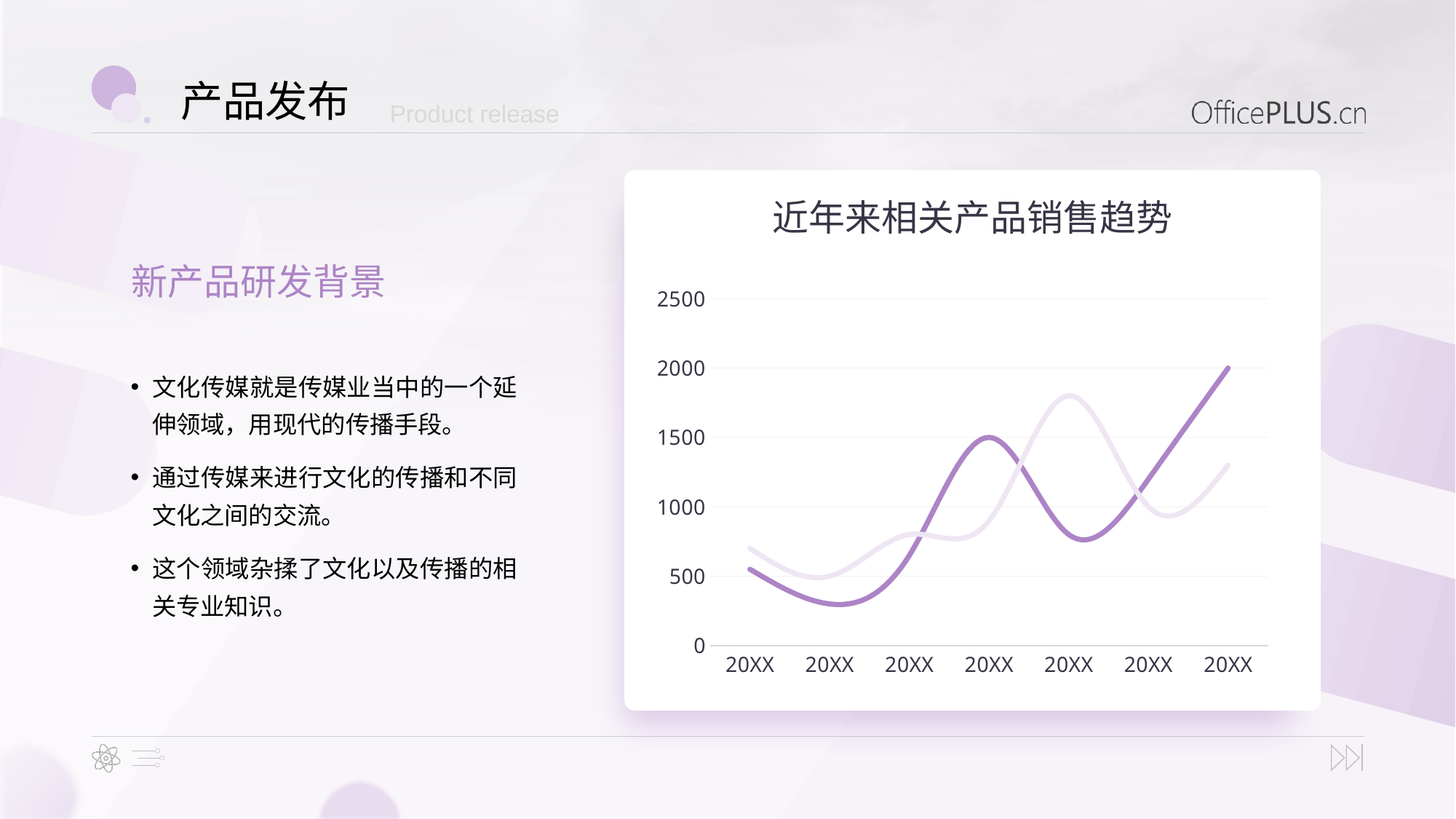
Is the value of the darker purple line at the last x-axis point greater or less than 1500? greater At the fifth x-axis point, which line is higher, the darker purple line or the lighter purple line? the lighter purple line Is the value of the lighter purple line at the fifth x-axis point greater or less than 1500? greater Does the darker purple line rise or fall from the fifth x-axis point to the last x-axis point? rise How many points are there along the x axis of the chart? 7 What kind of chart is shown on the slide? line chart Is the value of the darker purple line at the first x-axis point greater or less than 1000? less At which x-axis point does the darker purple line reach its highest value? the last (seventh) point How many lines are plotted in the chart? 2 At the last x-axis point, which line is higher, the darker purple line or the lighter purple line? the darker purple line What is the title of the chart? 近年来相关产品销售趋势